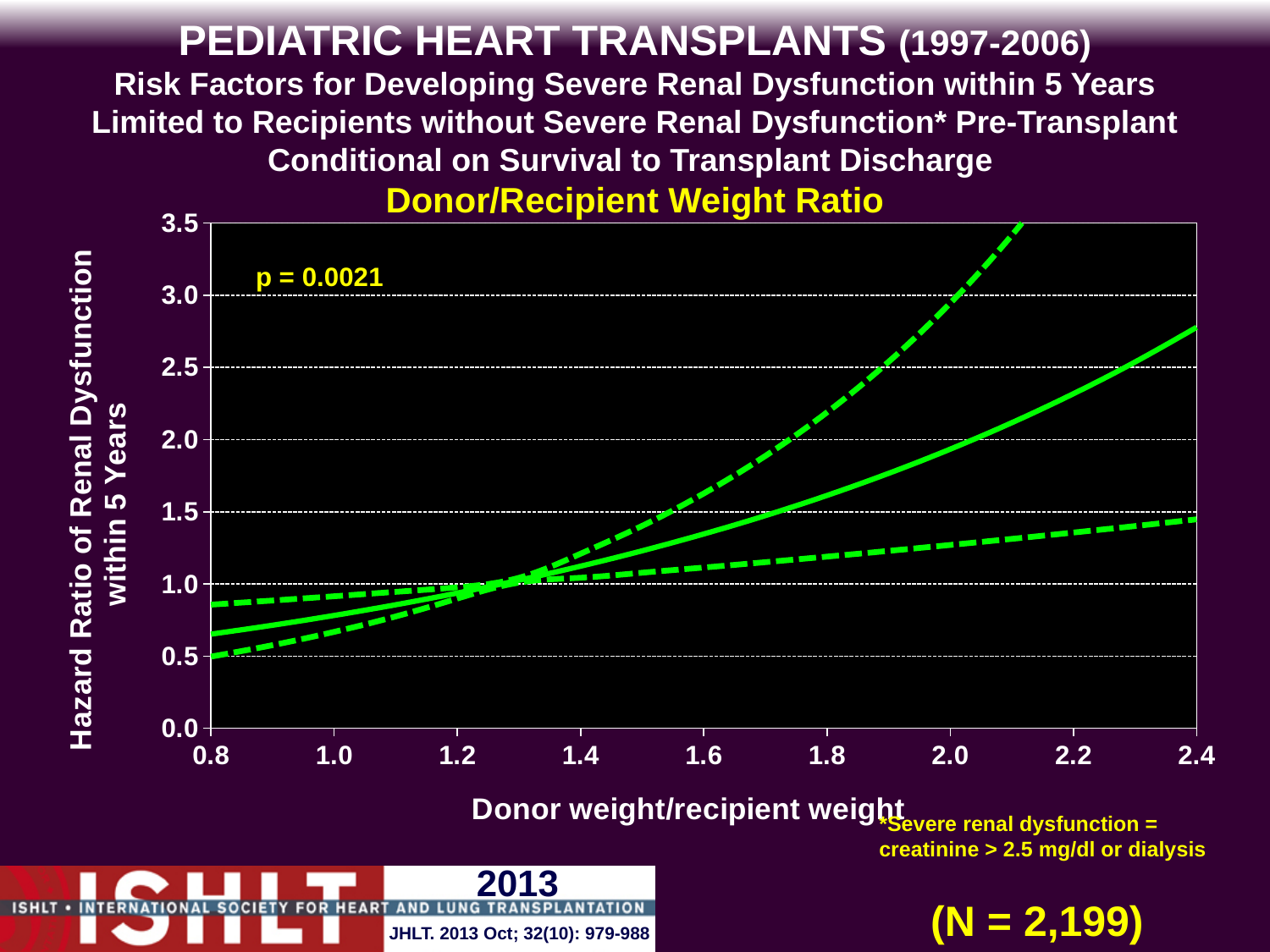
How many lines are plotted on the chart? 3 What kind of chart is shown on the slide? line chart Does the solid line rise or fall as the donor weight/recipient weight ratio increases from 0.8 to 2.4? rise Is the hazard ratio on the solid line at a donor/recipient weight ratio of 2.4 greater or less than 2.5? greater Is the lower dashed line at a donor/recipient weight ratio of 0.8 greater or less than 1.0? less What p-value is printed on the chart? p = 0.0021 What is the sample size (N) printed on the slide? N = 2,199 What is the label of the x axis? Donor weight/recipient weight Is the lower dashed line at a donor/recipient weight ratio of 2.4 greater or less than 1.0? greater What is the highest value shown on the y axis? 3.5